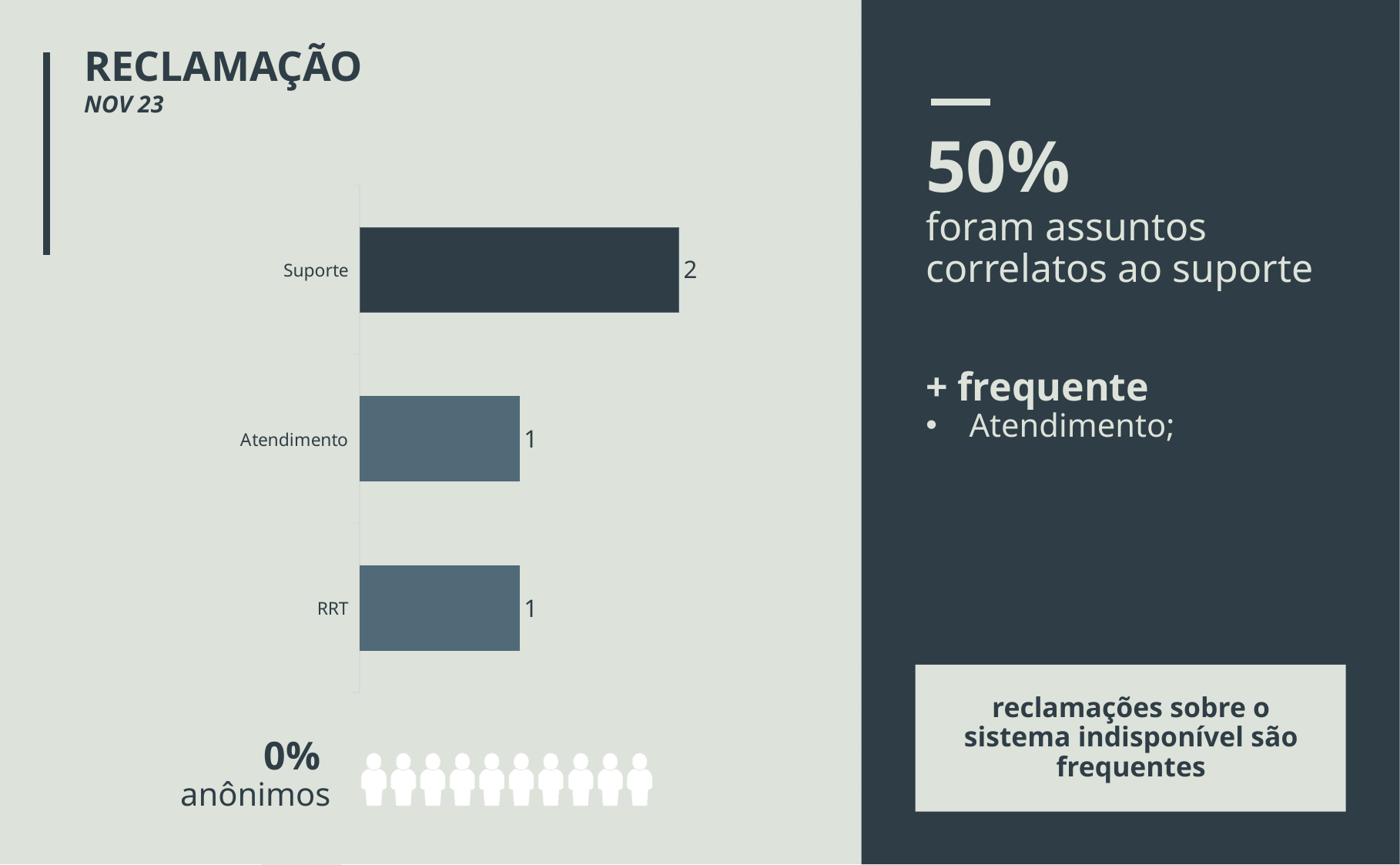
How many categories are shown in the chart? 3 Which is larger, the value for Suporte or the value for RRT? Suporte Which category is listed at the top of the chart? Suporte What is the value for Atendimento? 1 What kind of chart is shown on the slide? bar chart What is the value for RRT? 1 What is the difference between the values for Suporte and Atendimento? 1 What is the value for Suporte? 2 What is the total of all the values shown in the chart? 4 Which category has the highest value? Suporte Are the bars in the chart horizontal or vertical? horizontal